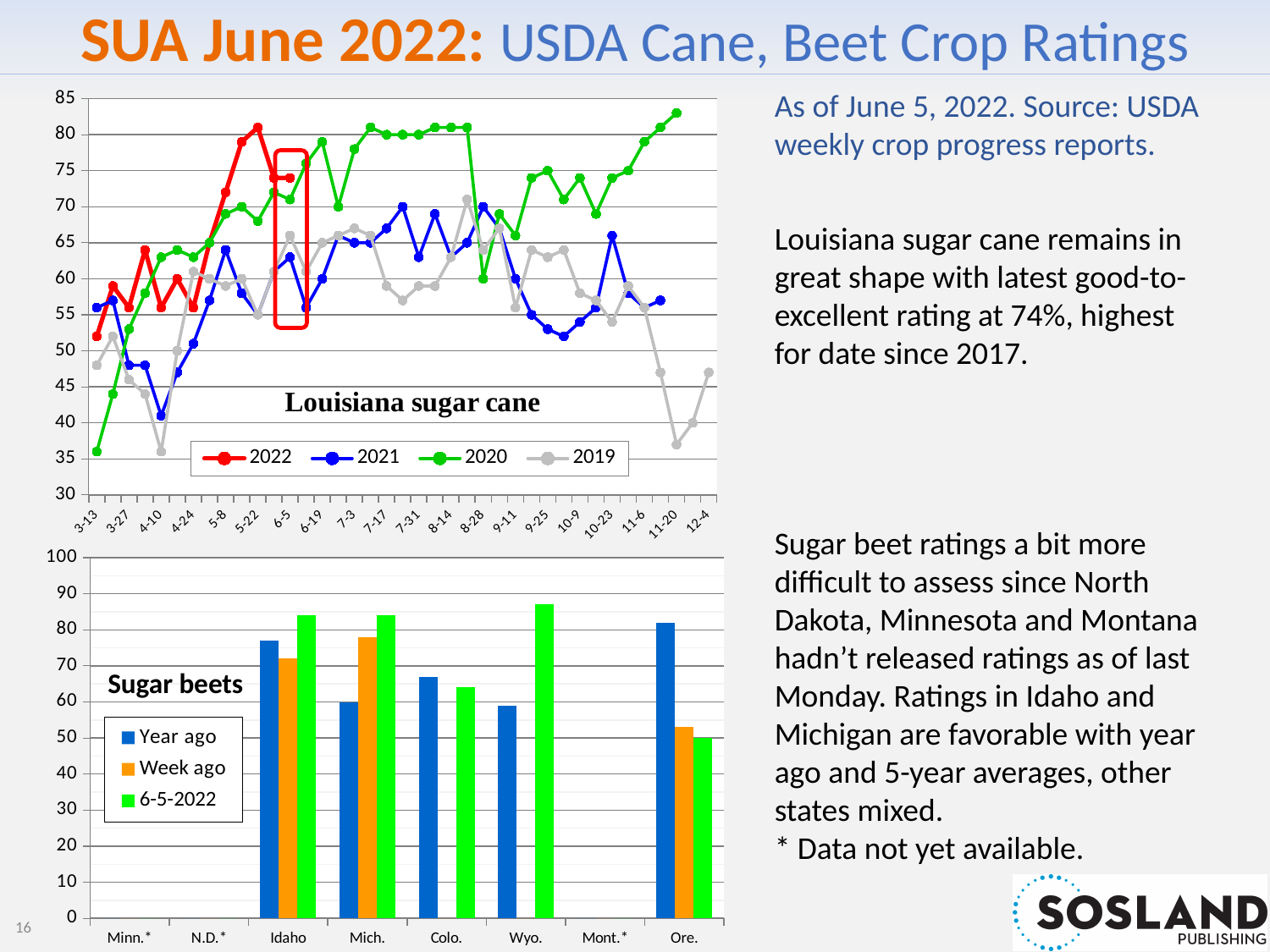
In the "Sugar beets" chart, which is larger for Idaho: the Year ago value or the 6-5-2022 value? 6-5-2022 In the "Sugar beets" chart, which state has the lowest 6-5-2022 value? Ore. What kind of chart is the top chart titled "Louisiana sugar cane"? line chart How many series does the legend of the "Sugar beets" chart list? 3 How many states are shown on the x axis of the "Sugar beets" chart? 8 How many series does the legend of the "Louisiana sugar cane" chart list? 4 In the "Sugar beets" chart, which state has the highest 6-5-2022 value? Wyo. In the "Louisiana sugar cane" chart, is the 2020 value at 11-20 greater or less than 80? greater In the "Sugar beets" chart, is the 6-5-2022 value for Wyo. greater or less than 80? greater What kind of chart is the bottom chart titled "Sugar beets"? bar chart In the "Louisiana sugar cane" chart, which year is plotted in red? 2022 In the "Sugar beets" chart, is the Week ago value for Ore. greater or less than 60? less